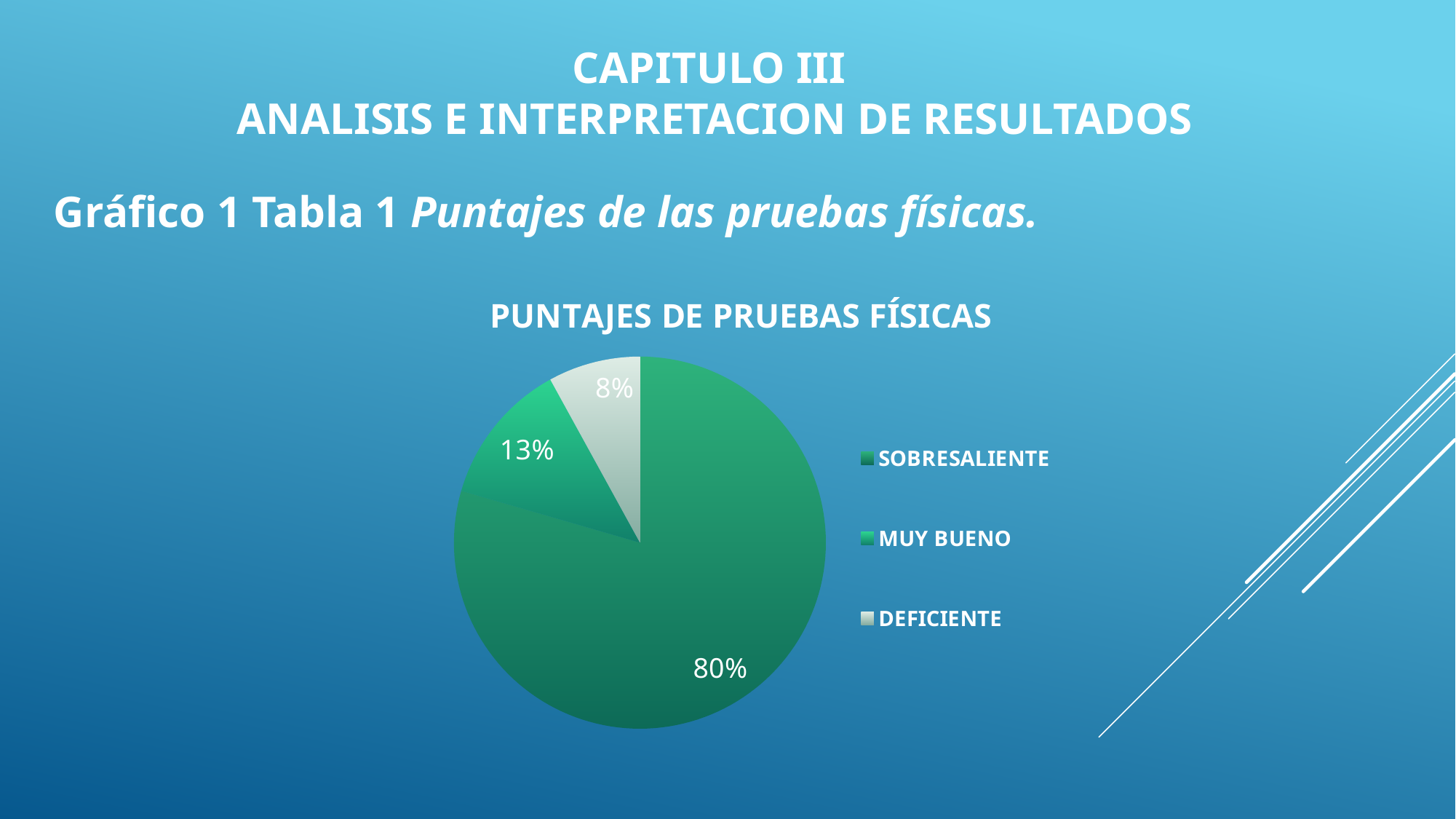
Which category has the largest slice of the pie? SOBRESALIENTE What is the title of the chart? PUNTAJES DE PRUEBAS FÍSICAS Which category has the smallest slice of the pie? DEFICIENTE What percentage is shown for SOBRESALIENTE? 80% What percentage is shown for MUY BUENO? 13% How many categories does the legend list? 3 What is the difference in percentage points between SOBRESALIENTE and MUY BUENO? 67 What is the difference in percentage points between MUY BUENO and DEFICIENTE? 5 What percentage is shown for DEFICIENTE? 8% What share of the pie does the SOBRESALIENTE slice represent? 80% Which is larger, the share for MUY BUENO or the share for DEFICIENTE? MUY BUENO What kind of chart is shown on the slide? pie chart